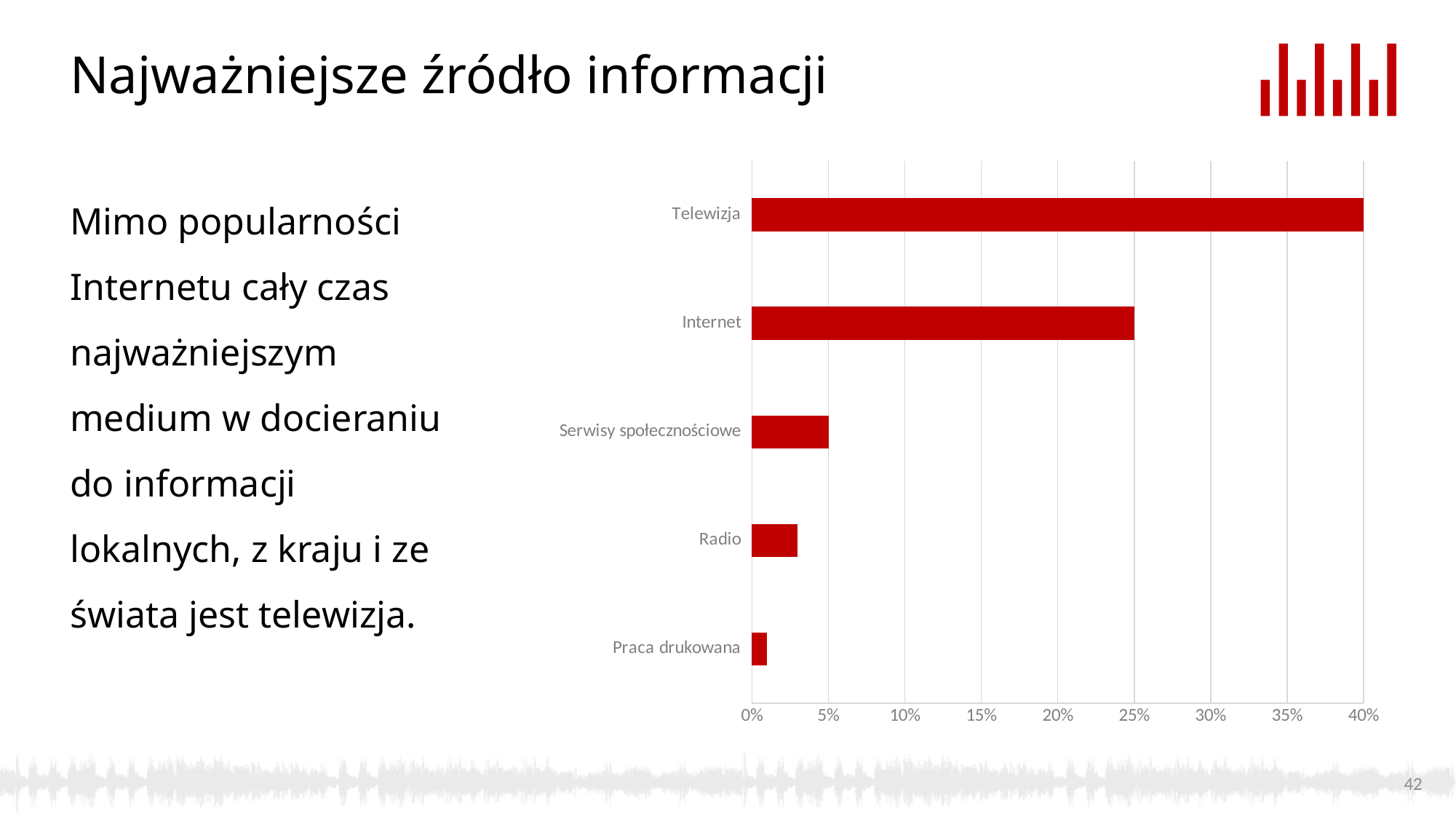
Is the value for Radio greater or less than 5%? less How many categories are shown in the chart? 5 What is the difference between the values for Telewizja and Internet? 15% Which category has the lowest value in the chart? Praca drukowana What kind of chart is shown on the slide? bar chart What is the highest value shown on the horizontal axis of the chart? 40% What is the value for Serwisy społecznościowe? 5% Which category has the highest value in the chart? Telewizja What is the value for Internet? 25% Is the value for Praca drukowana greater or less than 5%? less What is the value for Telewizja? 40% Which is larger, the value for Internet or the value for Serwisy społecznościowe? Internet